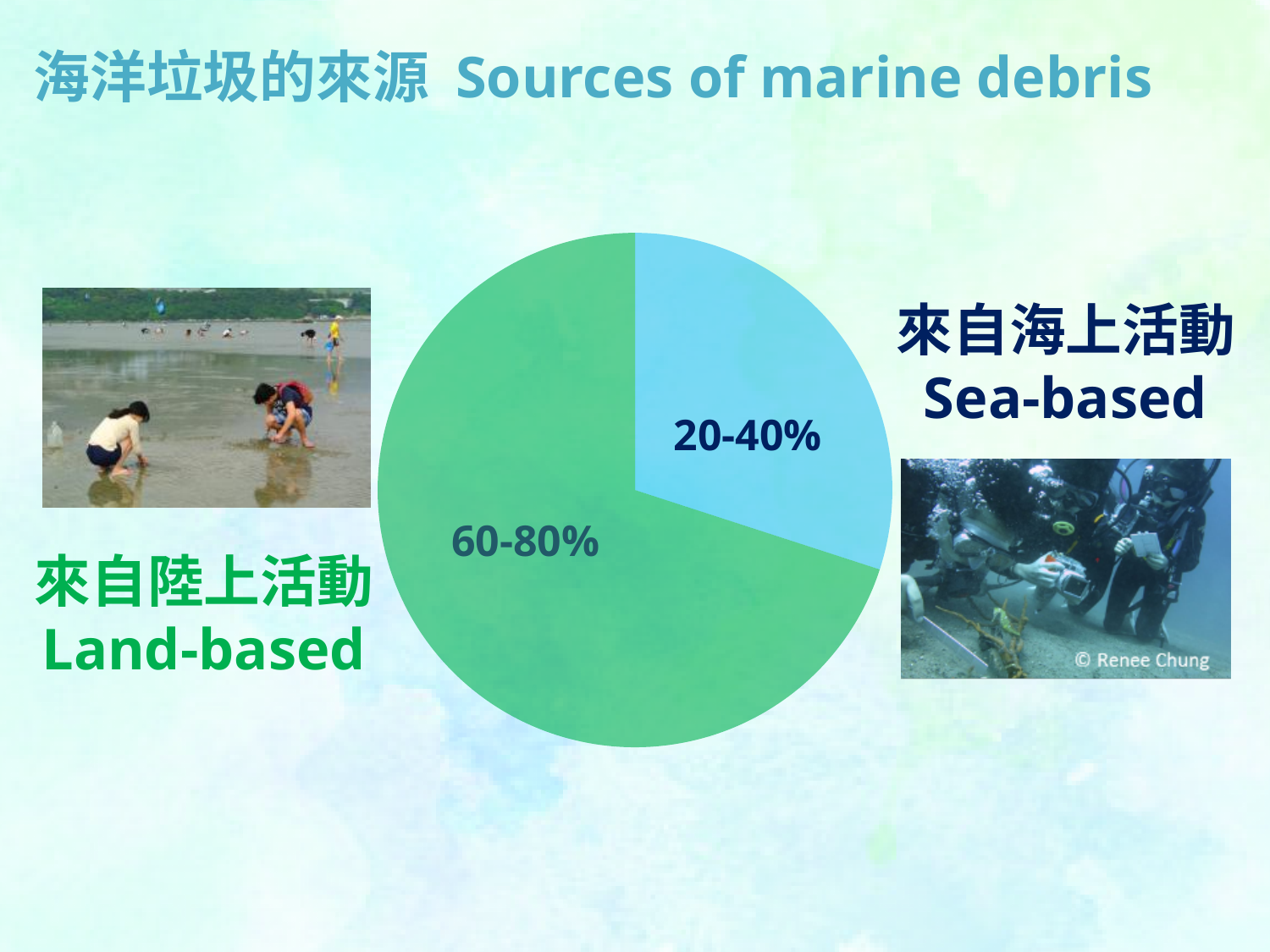
What kind of chart is shown on the slide? pie chart What colour is the land-based slice of the pie? green Which source has the smallest slice of the pie? Sea-based What share of marine debris is labelled as coming from land-based sources? 60-80% What is the English title of the slide? Sources of marine debris How many slices does the pie chart have? 2 What share of marine debris is labelled as coming from sea-based sources? 20-40% What colour is the sea-based slice of the pie? light blue Which source has the largest slice of the pie? Land-based Which source accounts for the larger share of marine debris, land-based or sea-based? Land-based